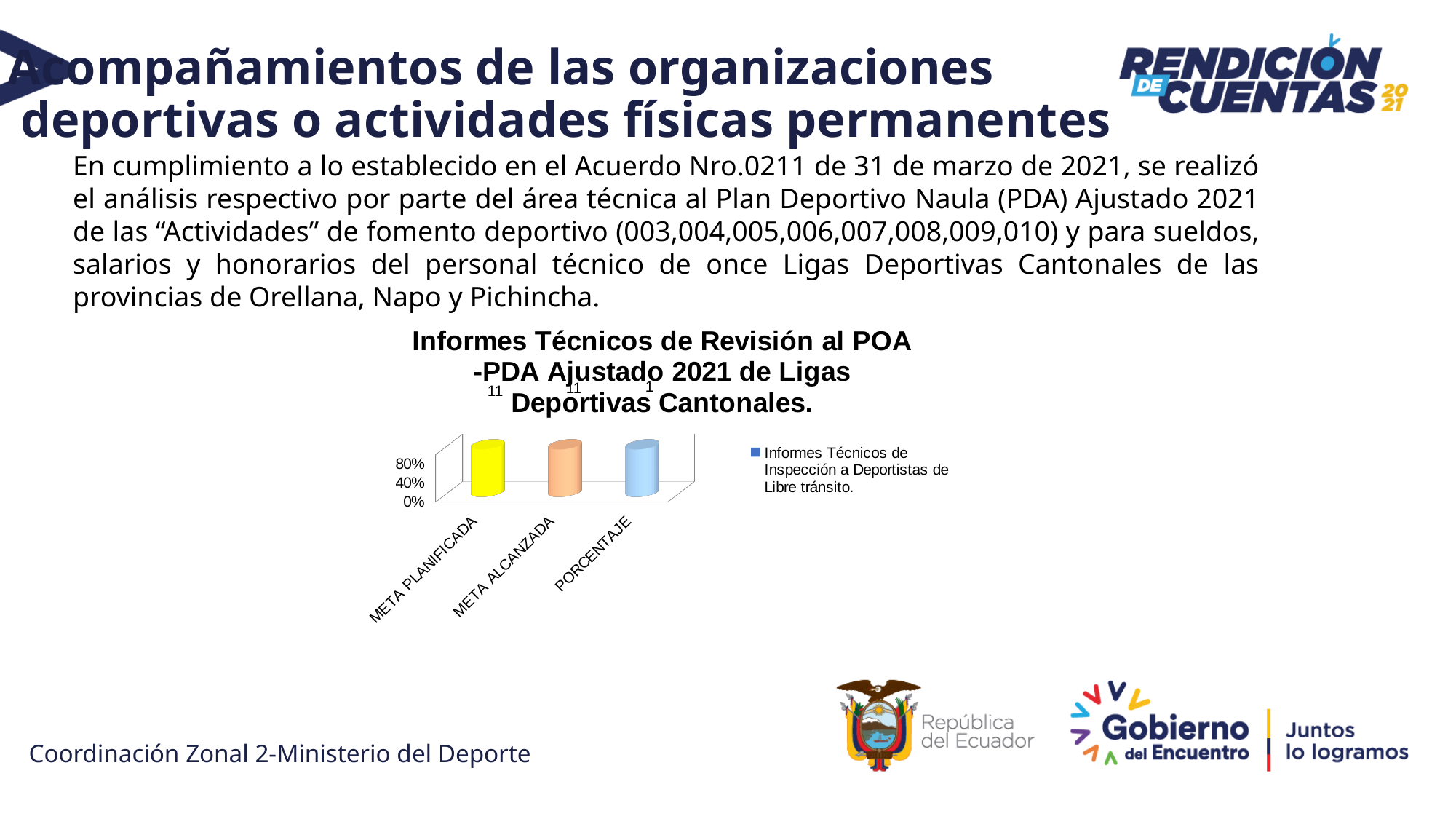
What is the difference between the data labels for META PLANIFICADA and META ALCANZADA? 0 What colour is the bar for META PLANIFICADA? yellow What is the data label shown for META ALCANZADA? 11 What kind of chart is shown on the slide? bar chart What is the title of the chart? Informes Técnicos de Revisión al POA -PDA Ajustado 2021 de Ligas Deportivas Cantonales. What is the data label shown for PORCENTAJE? 1 How many series does the chart legend list? 1 How many categories are shown on the x axis of the chart? 3 What is the data label shown for META PLANIFICADA? 11 Is the bar for META PLANIFICADA greater or less than 80% on the axis? greater